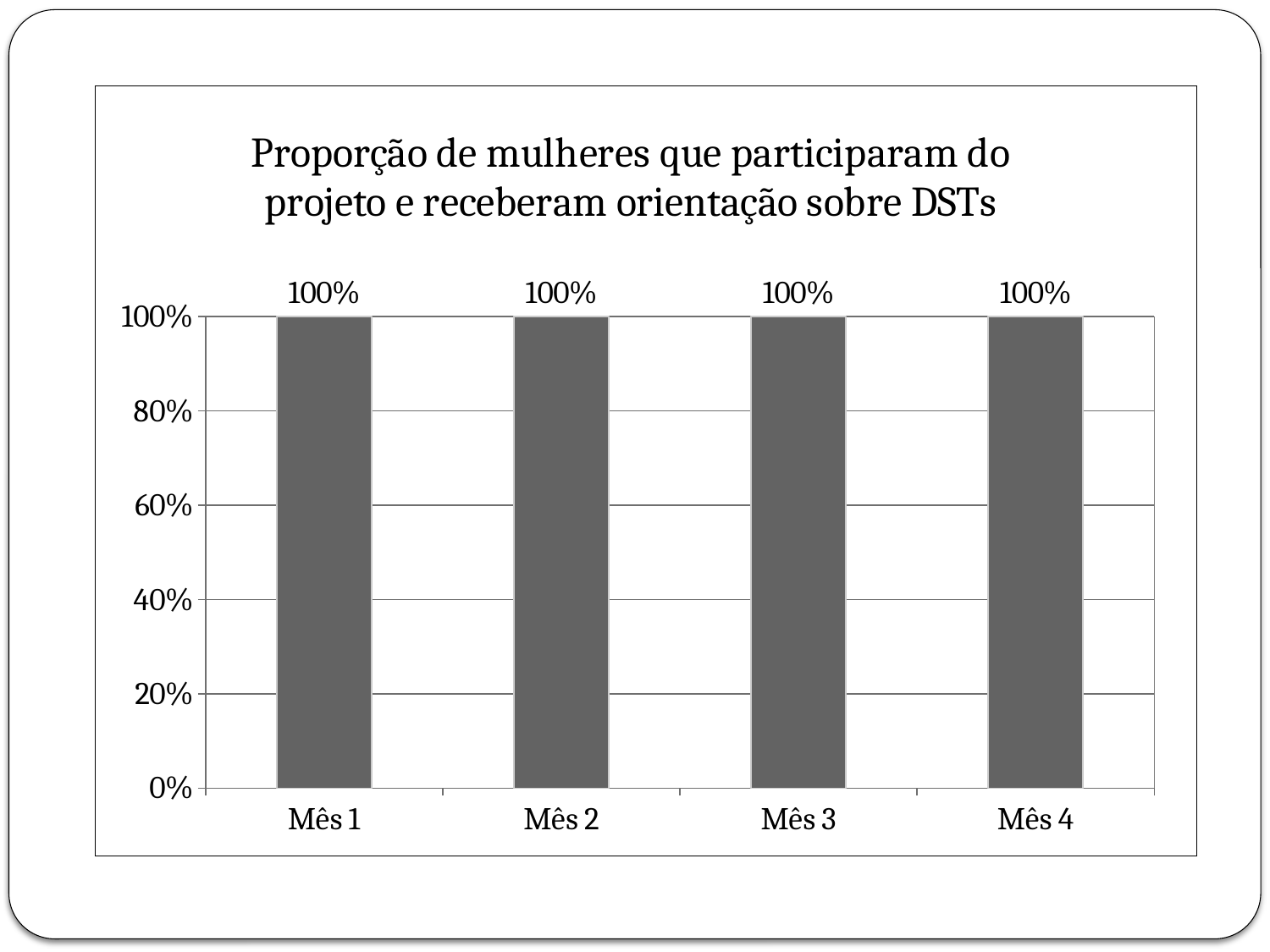
What is the difference between the values for Mês 2 and Mês 4? 0% How many categories are shown on the x axis? 4 What kind of chart is this? bar chart Is the value for Mês 2 greater or less than 80%? greater What is the highest value shown on the y axis? 100% Do the values rise, fall or stay the same from Mês 1 to Mês 4? stay the same What is the title of the chart? Proporção de mulheres que participaram do projeto e receberam orientação sobre DSTs What is the value for Mês 4? 100% What is the value for Mês 3? 100% What is the value for Mês 1? 100%